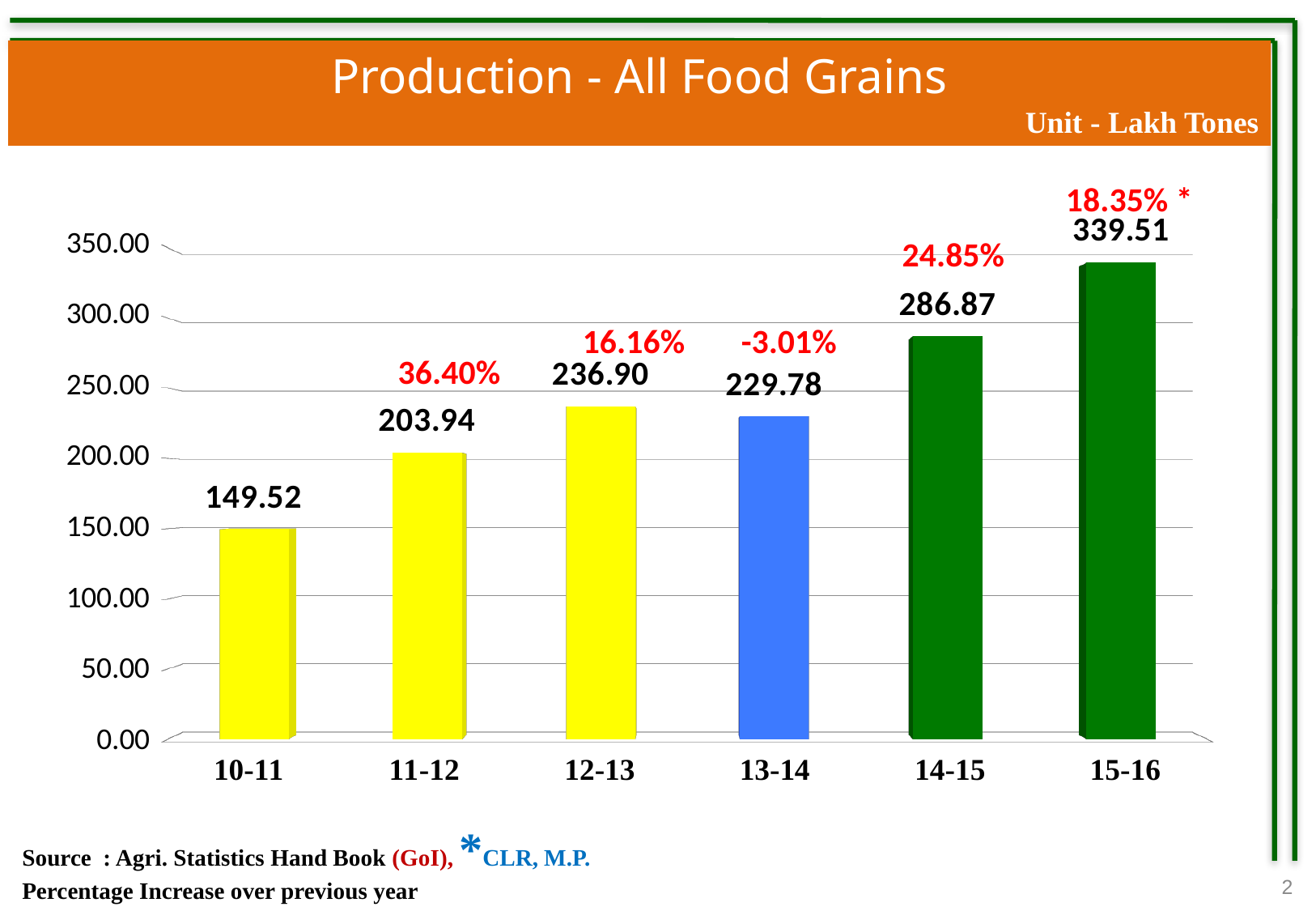
What percentage change over the previous year is shown for 13-14? -3.01% What is the production value for 15-16? 339.51 What kind of chart is shown on the slide? Bar chart What is the production value for 10-11? 149.52 Which year has the highest production? 15-16 What percentage increase over the previous year is shown for 11-12? 36.40% Which year has higher production, 12-13 or 13-14? 12-13 Which year has the lowest production? 10-11 What is the difference in production between 15-16 and 14-15? 52.64 What is the production value for 13-14? 229.78 What unit is stated for the production values on the slide? Lakh Tones How many years are shown on the x axis? 6